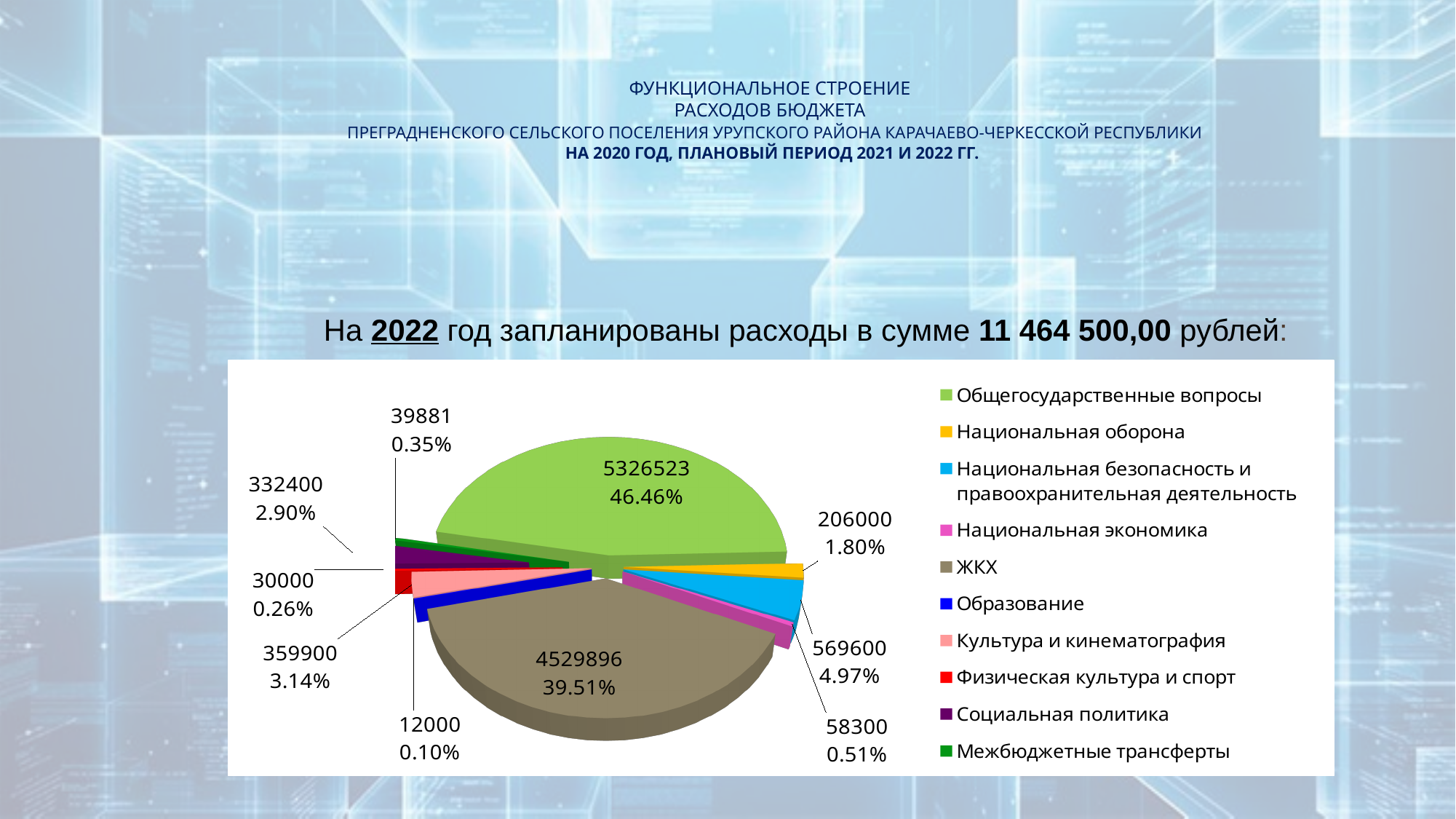
Which category has the largest slice of the pie? Общегосударственные вопросы What share of the pie does ЖКХ represent? 39.51% What value is shown for Общегосударственные вопросы in the pie chart? 5326523 Which category has the smallest slice of the pie? Образование What total planned expenditure for 2022 is stated above the chart? 11 464 500,00 рублей What percentage is shown for Национальная оборона? 1.80% What is the difference between the values for Общегосударственные вопросы and ЖКХ? 796627 Which is larger: the value for Культура и кинематография or the value for Социальная политика? Культура и кинематография What value is shown for Национальная безопасность и правоохранительная деятельность? 569600 What value is shown for Межбюджетные трансферты? 39881 What type of chart is shown on the slide? pie chart How many categories does the legend of the pie chart list? 10